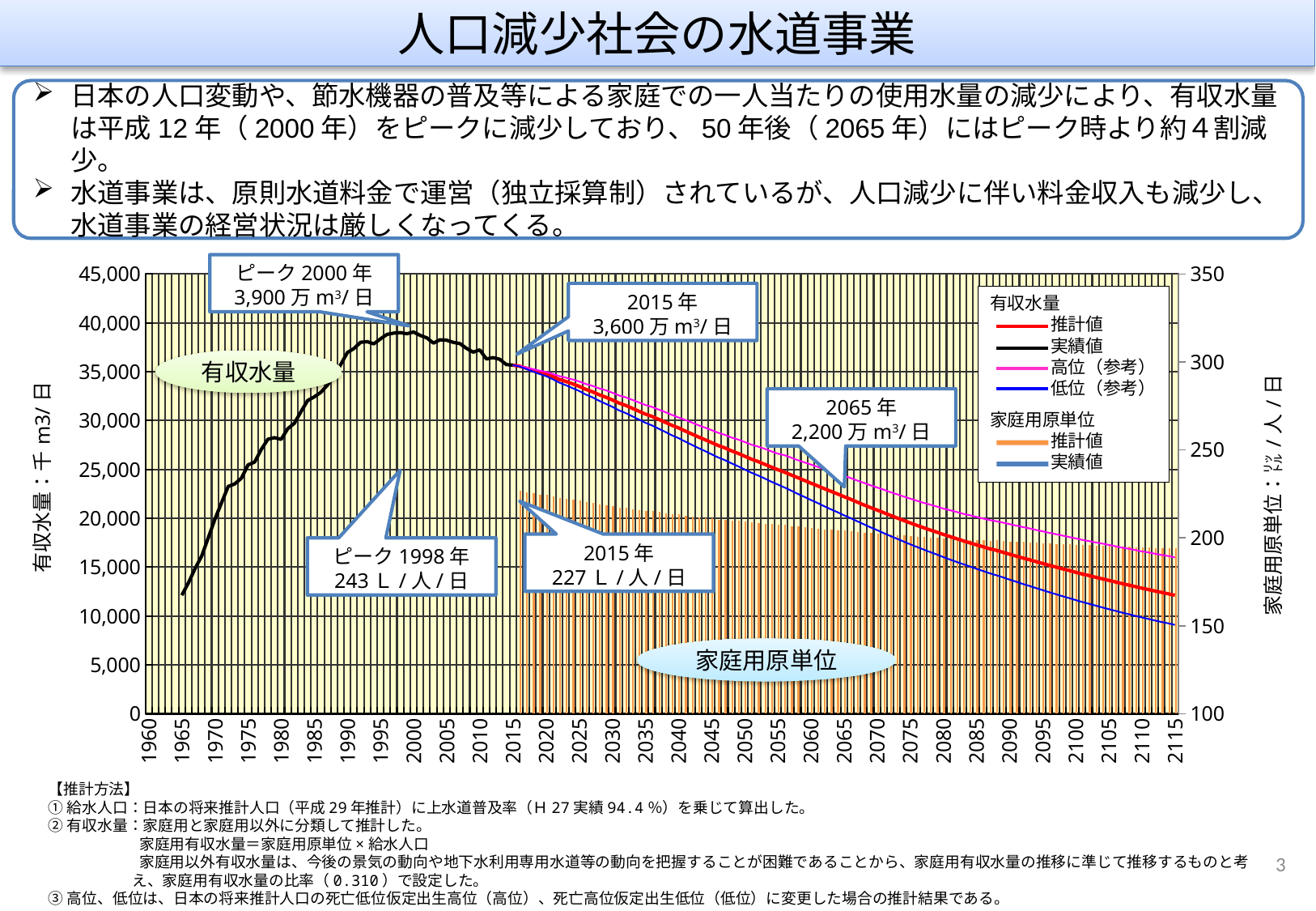
What value of 有収水量 does the callout give for 2015年? 3,600万 m3/日 In which year does the chart mark the peak of 有収水量? 2000年 In which year did 家庭用原単位 peak according to the chart? 1998年 Is the 有収水量 推計値 (red line) value in 2115 greater or less than 15,000 千 m3/日? less By how much is the 2065年 有収水量 lower than the 2000年 peak, based on the callout values? 1,700万 m3/日 How many series does the legend list in total? 6 Does the 有収水量 推計値 line rise or fall from 2015 to 2115? fall What colour is the 有収水量 推計値 line in the legend? red What was the peak value of 有収水量 in 2000 according to the callout? 3,900万 m3/日 What is the 家庭用原単位 value shown for 2015年? 227 L/人/日 What was the peak value of 家庭用原単位 in 1998? 243 L/人/日 What value of 有収水量 does the callout give for 2065年? 2,200万 m3/日